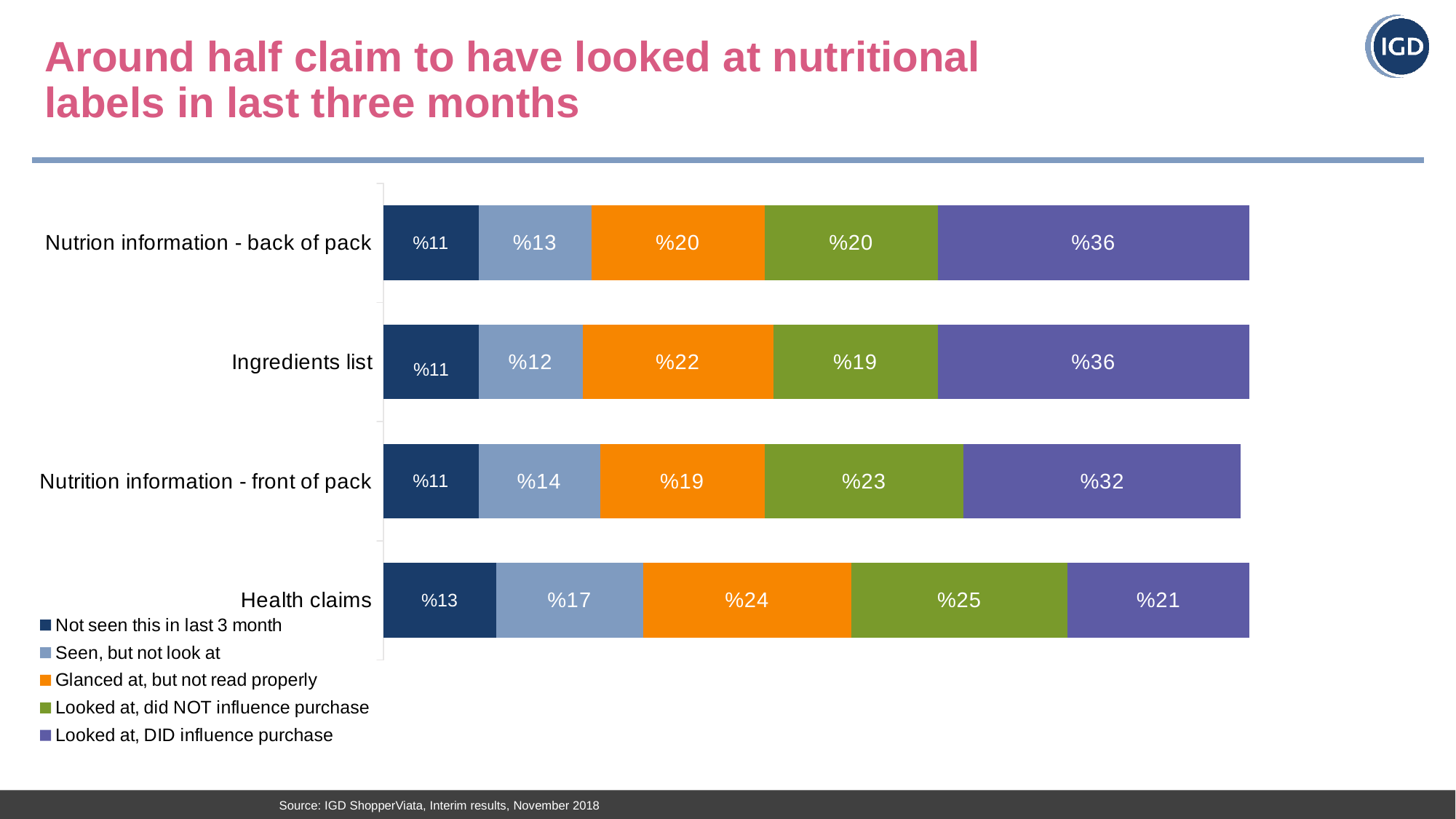
Which category has the lowest value for 'Looked at, DID influence purchase'? Health claims What is the difference between the 'Looked at, DID influence purchase' values for Nutrion information - back of pack and Health claims? %15 What is the value for 'Glanced at, but not read properly' for Health claims? %24 How many categories are plotted on the chart? 4 What is the value for 'Looked at, DID influence purchase' for Ingredients list? %36 How many series does the legend list? 5 What is the value for 'Seen, but not look at' for Nutrition information - front of pack? %14 What is the total of the stacked bar for Nutrition information - front of pack? %99 Which category has the highest value for 'Not seen this in last 3 month'? Health claims Which is larger: the 'Looked at, did NOT influence purchase' value for Nutrition information - front of pack or for Ingredients list? Nutrition information - front of pack Which legend entry is shown in orange? Glanced at, but not read properly What kind of chart is shown on the slide? Stacked bar chart